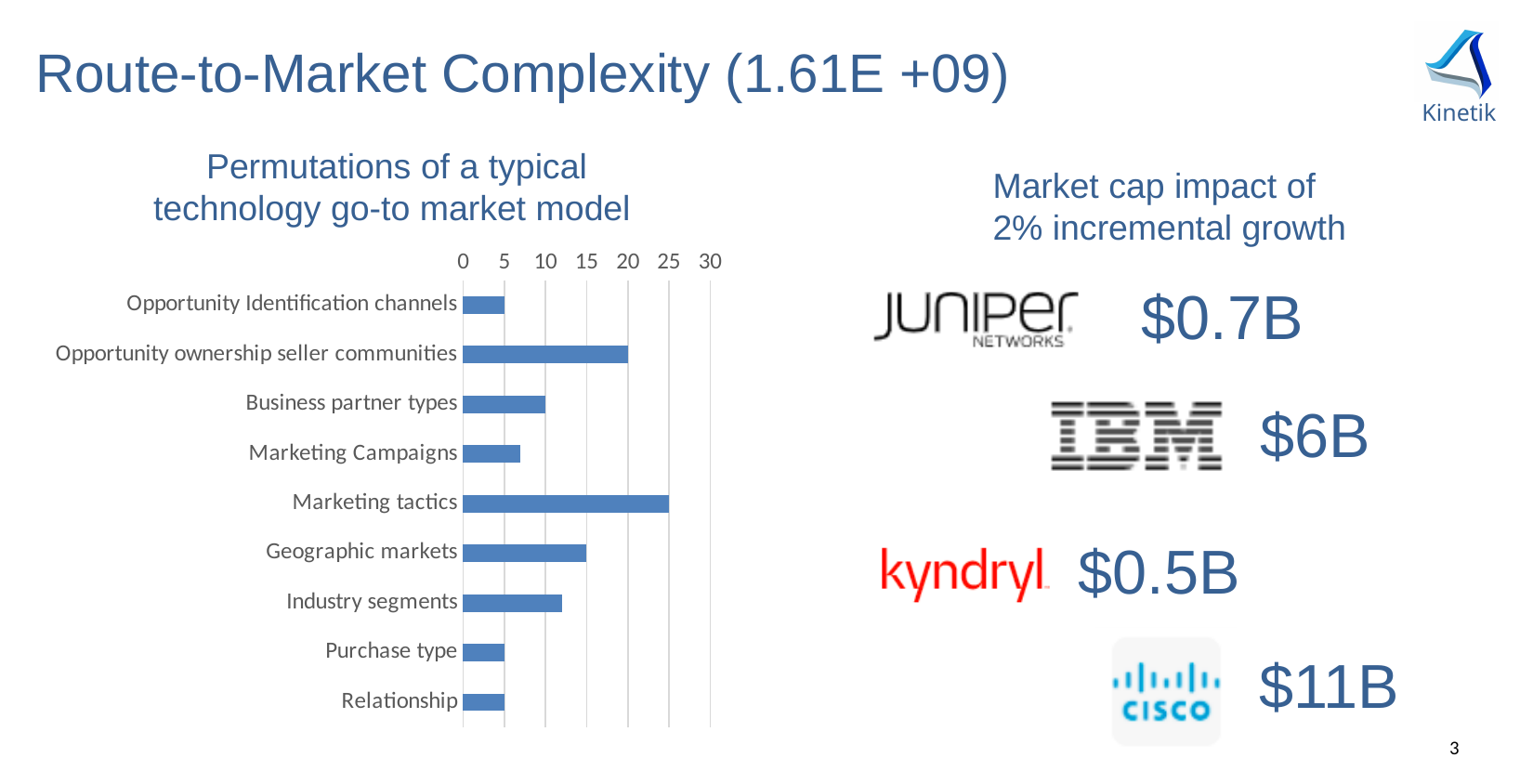
What is the value for Geographic markets? 15 What is the value for Business partner types? 10 What is the value for Opportunity ownership seller communities? 20 What kind of chart is shown on the slide? bar chart What is the difference between the values for Marketing tactics and Opportunity ownership seller communities? 5 Is the value for Marketing Campaigns greater or less than 10? less Is the value for Industry segments greater or less than 10? greater Which is larger, the value for Geographic markets or the value for Business partner types? Geographic markets Which category has the highest value in the bar chart? Marketing tactics What is the value for Marketing tactics? 25 How many categories does the bar chart show? 9 What is the title of the bar chart? Permutations of a typical technology go-to market model